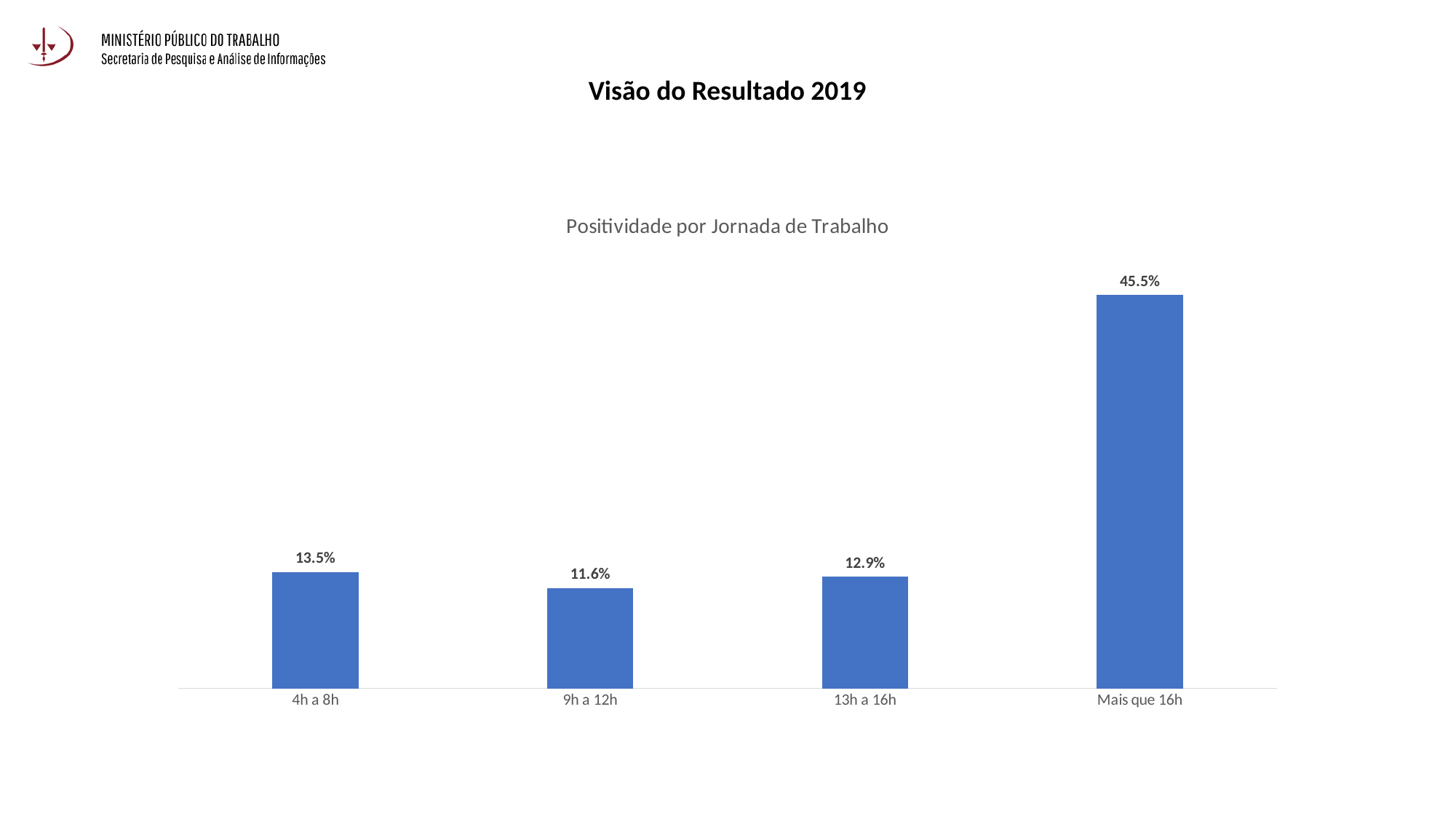
What is the value for '9h a 12h'? 11.6% What is the value for 'Mais que 16h'? 45.5% Which category has the highest value? Mais que 16h What kind of chart is shown on the slide? Bar chart What is the difference between the values for '13h a 16h' and '9h a 12h'? 1.3% How many categories are shown on the x axis? 4 What is the value for '13h a 16h'? 12.9% Which is larger, the value for '4h a 8h' or the value for '13h a 16h'? 4h a 8h What is the title of the chart? Positividade por Jornada de Trabalho What is the value for '4h a 8h'? 13.5% What is the difference between the values for 'Mais que 16h' and '4h a 8h'? 32.0% Which category has the lowest value? 9h a 12h